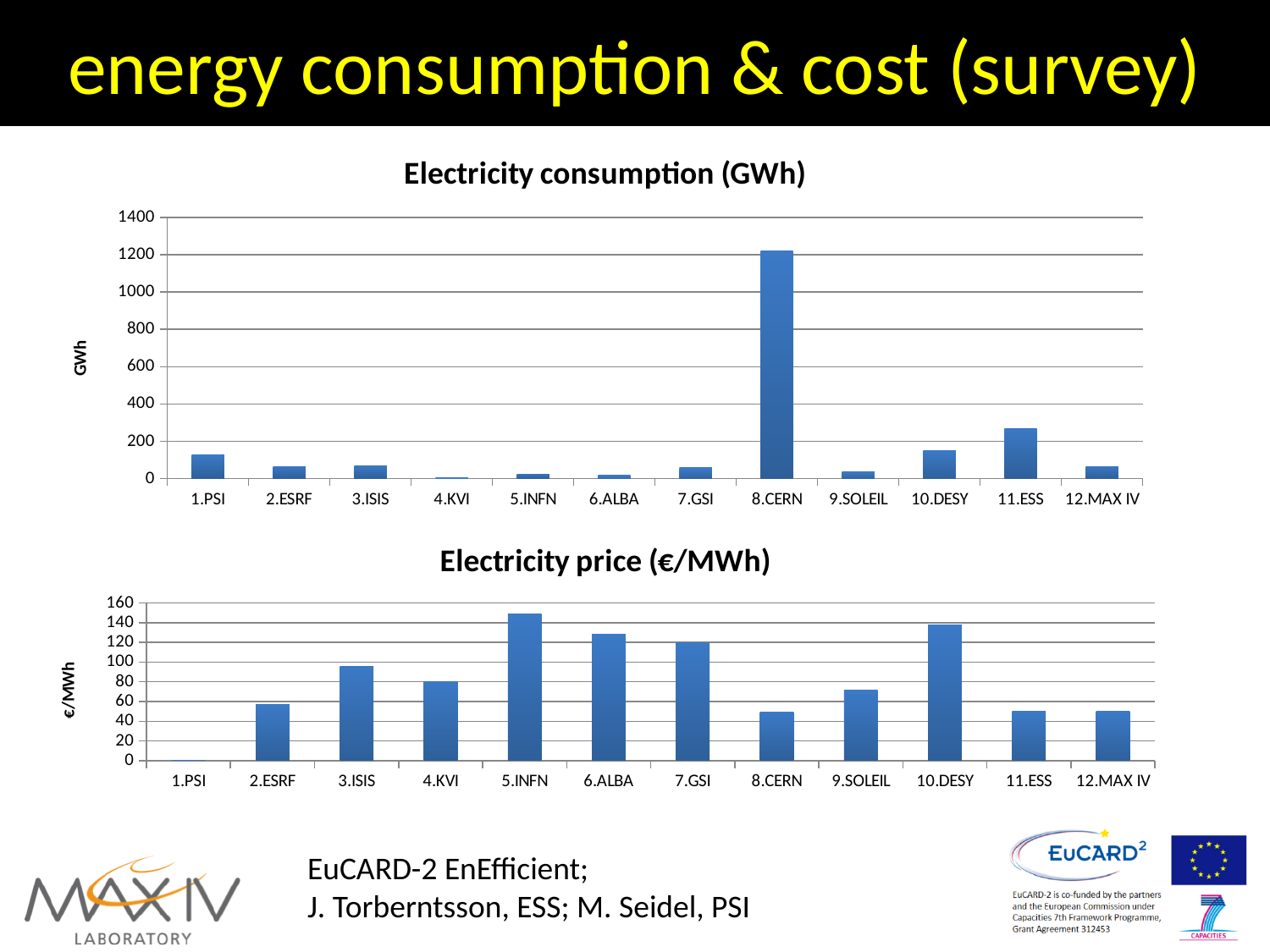
In the Electricity price (€/MWh) chart, is the value for 8.CERN greater or less than 60? less In the Electricity consumption (GWh) chart, is the value for 11.ESS greater or less than 200? greater What kind of chart is the Electricity price (€/MWh) chart? bar chart How many facilities are shown on the x axis of the Electricity consumption (GWh) chart? 12 In the Electricity consumption (GWh) chart, is the value for 1.PSI greater or less than 200? less In the Electricity price (€/MWh) chart, which has the higher electricity price, 9.SOLEIL or 10.DESY? 10.DESY In the Electricity consumption (GWh) chart, which facility has the highest electricity consumption? 8.CERN In the Electricity consumption (GWh) chart, which facility has the lowest electricity consumption? 4.KVI In the Electricity price (€/MWh) chart, which facility has the lowest electricity price? 1.PSI What is the y-axis label of the Electricity consumption chart? GWh